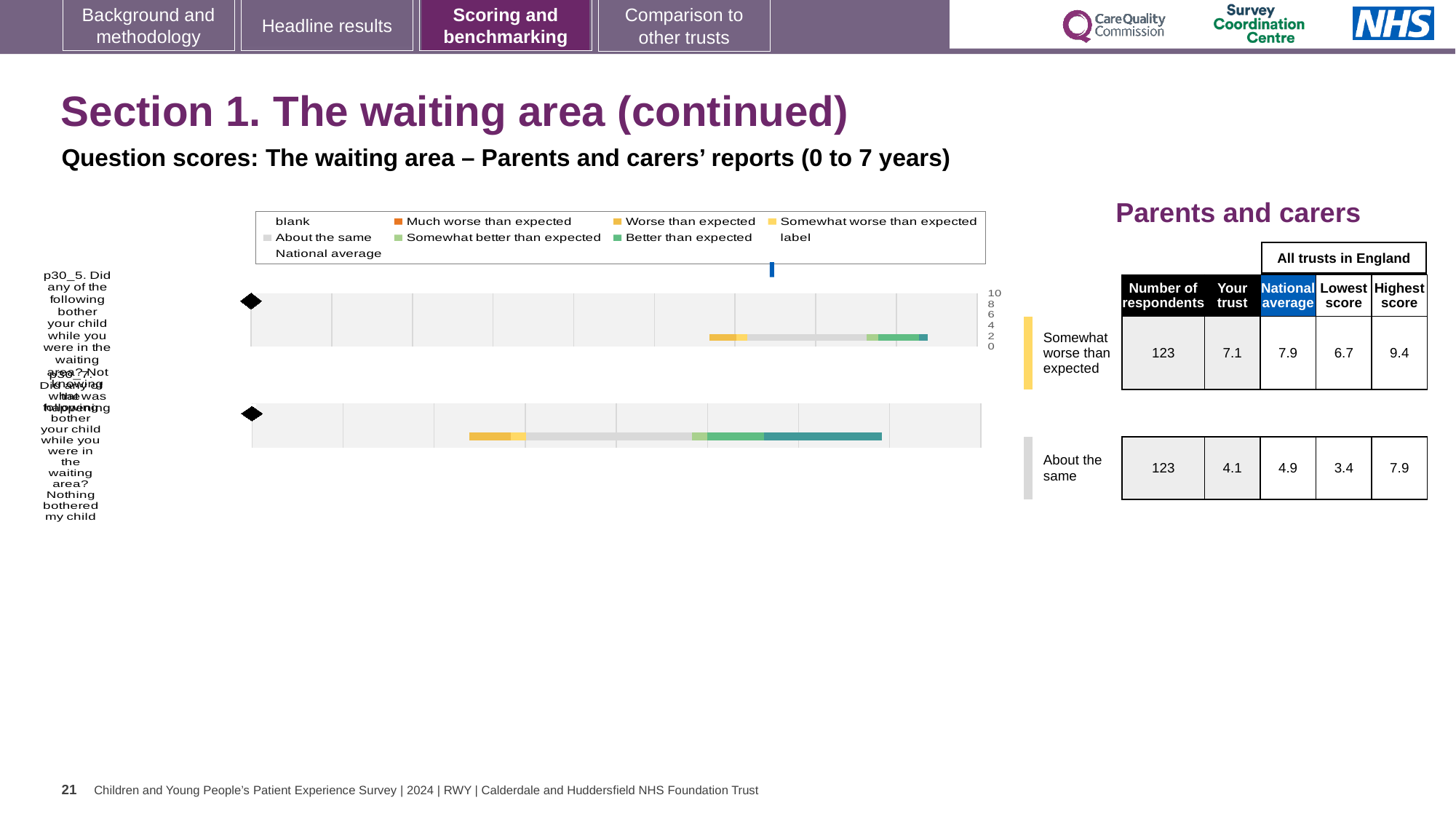
What is the national average for the top bar (rated 'Somewhat worse than expected')? 7.9 How many respondents answered the question shown in the top bar? 123 What is the 'Your trust' score for the bottom bar (rated 'About the same')? 4.1 For the bottom bar, what is the difference between the highest score and the lowest score across all trusts in England? 4.5 For the top bar, what is the difference between the national average and the 'Your trust' score? 0.8 Which bar has the higher 'Your trust' score, the top bar or the bottom bar? the top bar What is the highest score across all trusts in England for the bottom bar (rated 'About the same')? 7.9 For the top bar, which is larger: the 'Your trust' score or the national average? National average What kind of chart is shown on the slide? bar chart What is the highest value shown on the chart's axis? 10 What is the 'Your trust' score for the top bar (rated 'Somewhat worse than expected')? 7.1 How many horizontal bars are plotted in the chart? 2